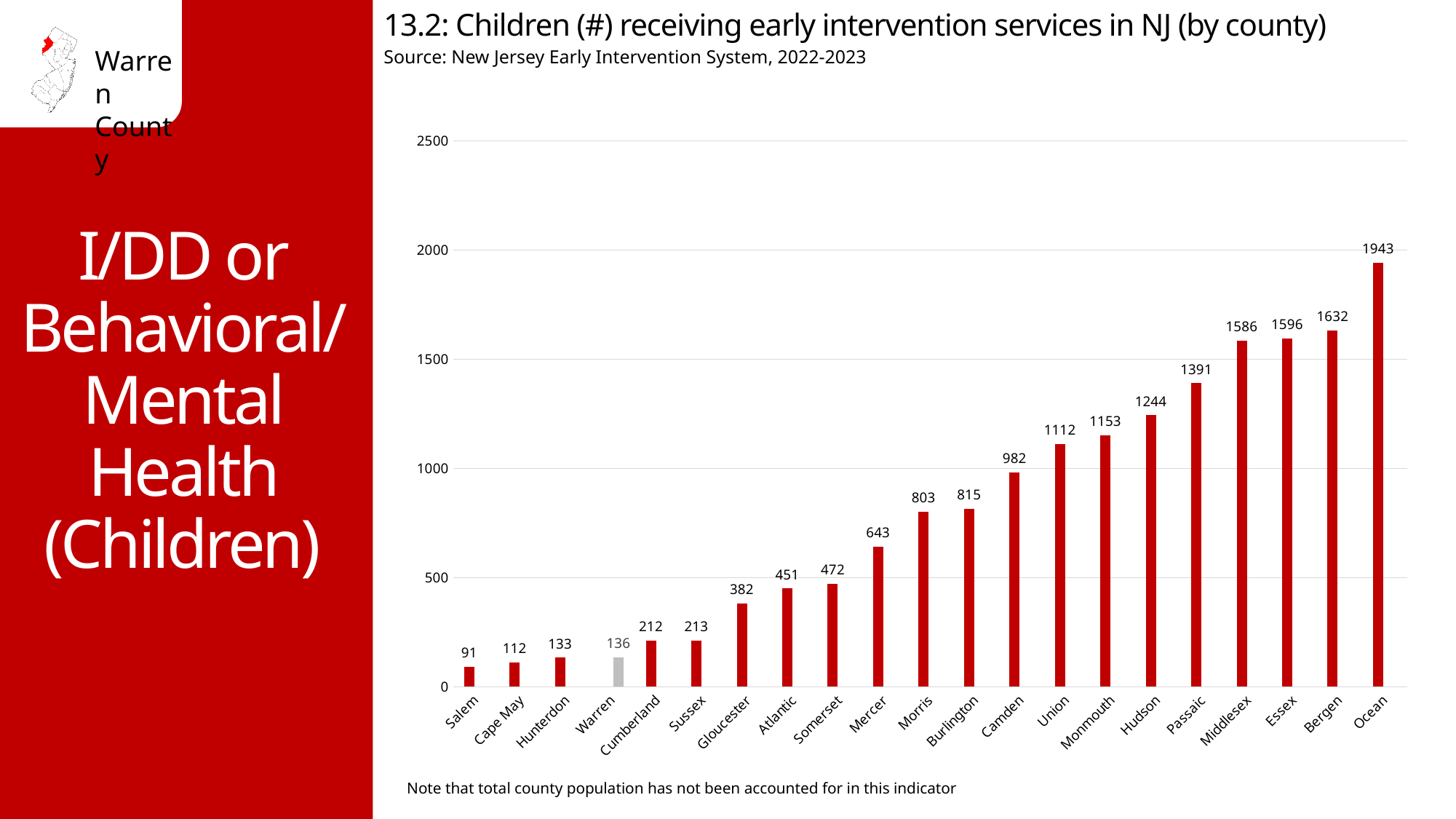
What is the value shown for Camden? 982 Which county has the highest number of children receiving early intervention services? Ocean What is the difference between the values for Warren and Hunterdon? 3 What is the value shown for Gloucester? 382 Which county has the lowest number of children receiving early intervention services? Salem How many children received early intervention services in Warren County? 136 How many counties are shown on the x axis? 21 What is the difference between the values for Ocean and Bergen? 311 What kind of chart is shown on the slide? Bar chart Which bar is coloured differently (grey) from the others? Warren Do the values rise or fall moving from left to right along the x axis? Rise Which has a larger value, Mercer or Morris? Morris